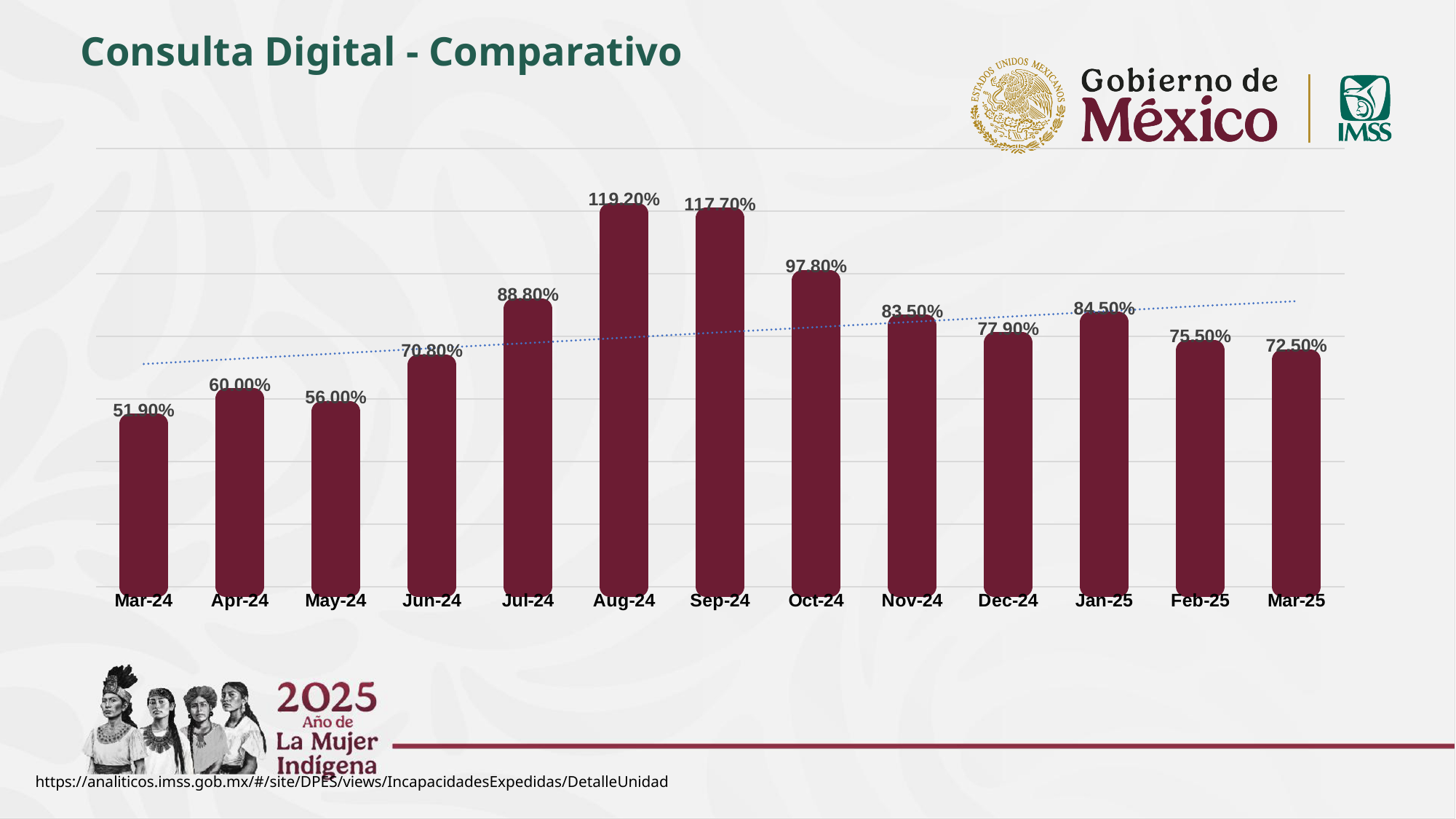
What is the value for Jan-25? 84.50% Which is larger, the value for Nov-24 or the value for Jan-25? Jan-25 What is the difference between the values for Aug-24 and Sep-24? 1.50% How many months are shown on the x axis? 13 Which is larger, the value for Apr-24 or the value for May-24? Apr-24 Which month has the lowest value? Mar-24 What is the difference between the values for Mar-25 and Mar-24? 20.60% What kind of chart is shown on the slide? Bar chart What is the title of the chart? Consulta Digital - Comparativo Which month has the highest value? Aug-24 What is the value for Aug-24? 119.20% What is the value for Mar-24? 51.90%